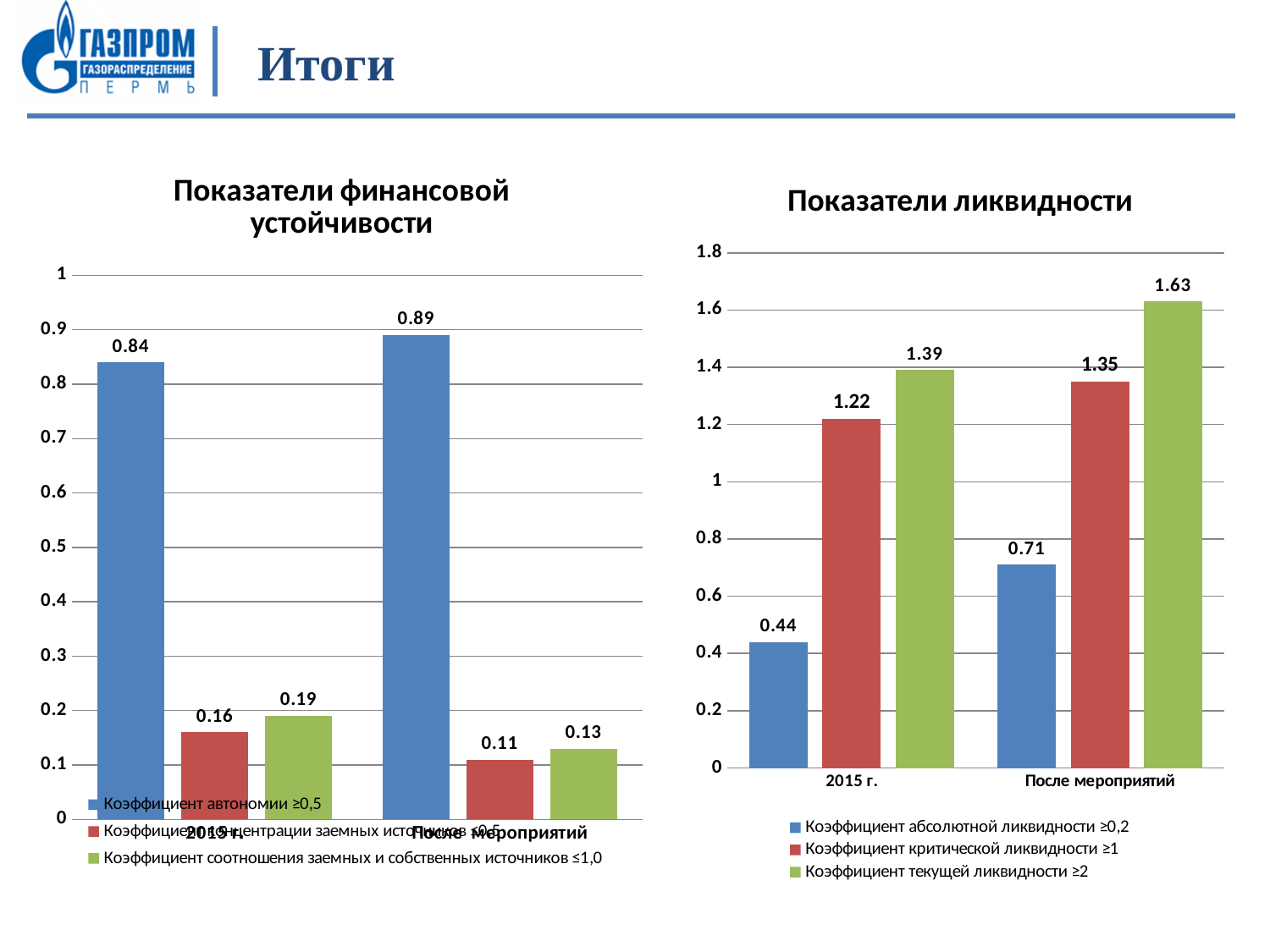
In the chart 'Показатели ликвидности', what is the difference between Коэффициент критической ликвидности ≥1 for После мероприятий and for 2015 г.? 0.13 In the chart 'Показатели финансовой устойчивости', what is the value of Коэффициент соотношения заемных и собственных источников ≤1,0 for 2015 г.? 0.19 In the chart 'Показатели ликвидности', is the value of Коэффициент критической ликвидности ≥1 for 2015 г. greater or less than 1? greater In the chart 'Показатели финансовой устойчивости', what is the value of Коэффициент автономии ≥0,5 for После мероприятий? 0.89 In the chart 'Показатели финансовой устойчивости', what is the difference between Коэффициент автономии ≥0,5 for После мероприятий and for 2015 г.? 0.05 In the chart 'Показатели ликвидности', which is larger: Коэффициент абсолютной ликвидности ≥0,2 for 2015 г. or for После мероприятий? После мероприятий In the chart 'Показатели ликвидности', what is the value of Коэффициент текущей ликвидности ≥2 for После мероприятий? 1.63 In the chart 'Показатели ликвидности', what is the value of Коэффициент абсолютной ликвидности ≥0,2 for 2015 г.? 0.44 How many series does the legend of the chart 'Показатели ликвидности' list? 3 In the chart 'Показатели ликвидности', which bar has the highest value? Коэффициент текущей ликвидности ≥2, После мероприятий In the chart 'Показатели финансовой устойчивости', which bar has the lowest value? 0.11 (После мероприятий, red series) What type of chart is 'Показатели финансовой устойчивости'? Bar chart